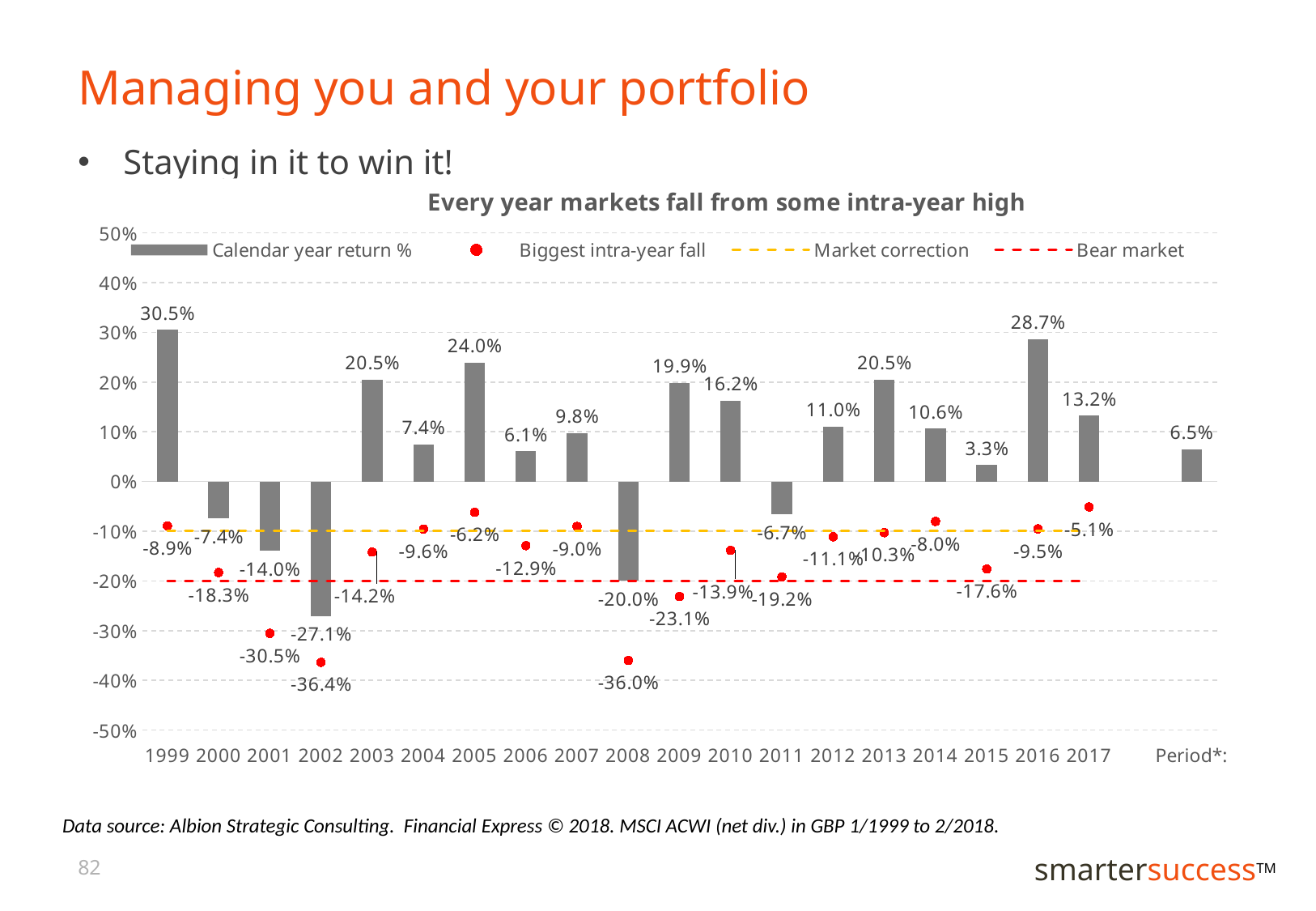
How many entries does the legend list? 4 Which year has the lowest calendar year return %? 2002 What is the biggest intra-year fall shown for 2008? -36.0% What is the biggest intra-year fall shown for 2001? -30.5% What is the calendar year return % shown for the Period* category? 6.5% What is the calendar year return % for 2016? 28.7% What kind of chart is used to show the calendar year return %? Bar chart What is the difference between the calendar year return % for 2013 and 2014? 9.9 percentage points Which year has the highest calendar year return %? 1999 How many individual years (excluding Period*) are shown on the x axis? 19 What is the title of the chart? Every year markets fall from some intra-year high Which year had the larger calendar year return %, 2003 or 2005? 2005